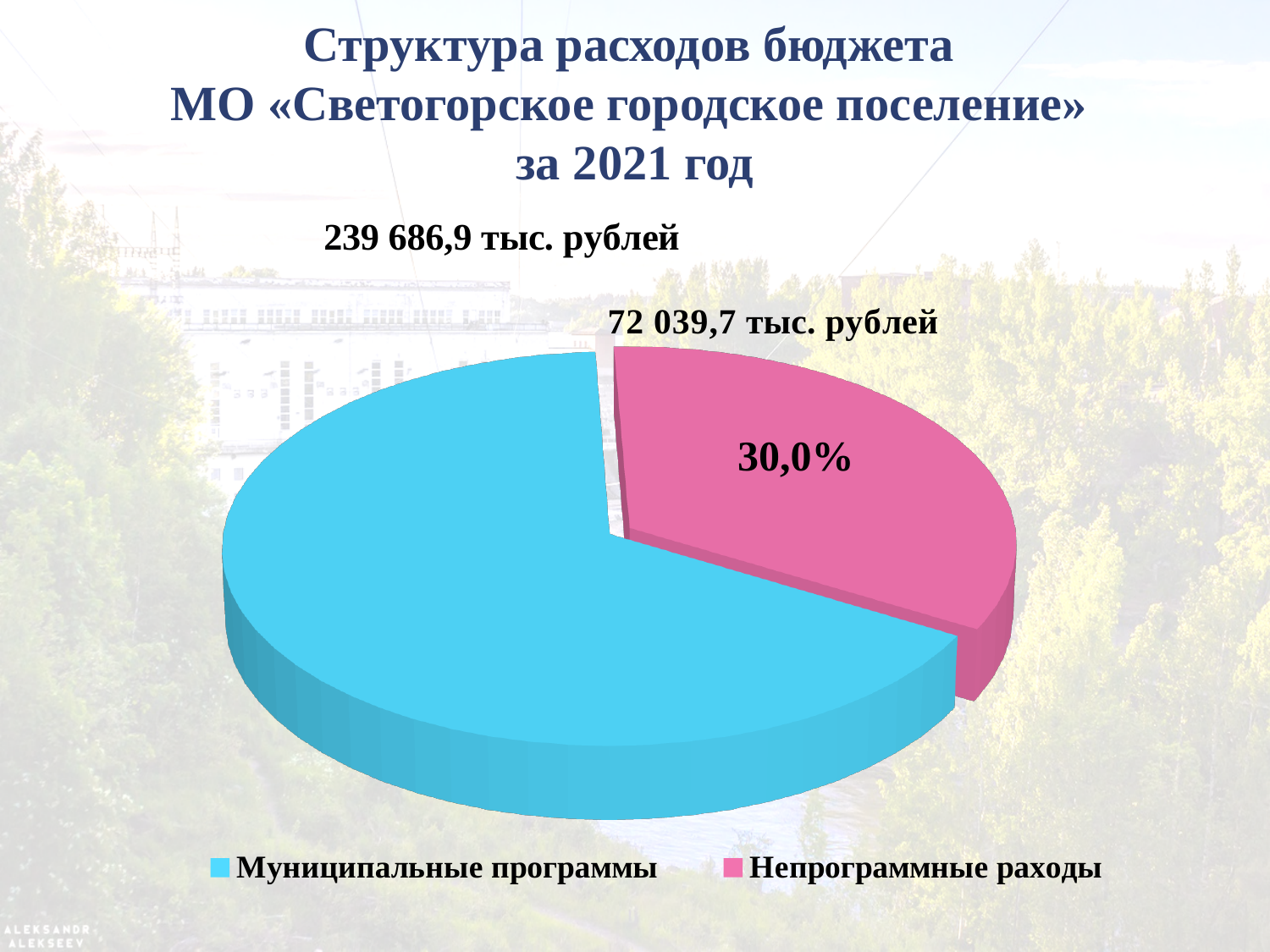
How many slices does the pie chart have? 2 Which category has the largest slice of the pie? Муниципальные программы Which is larger: Муниципальные программы or Непрограммные раходы? Муниципальные программы Which category has the smallest slice of the pie? Непрограммные раходы How many entries does the legend list? 2 For which year does the chart show the budget expenditure structure? 2021 What kind of chart is shown on the slide? Pie chart What value is shown for Непрограммные раходы? 72 039,7 тыс. рублей What colour is the slice for Непрограммные раходы? Pink What share of the pie does the slice for Непрограммные раходы represent? 30,0%